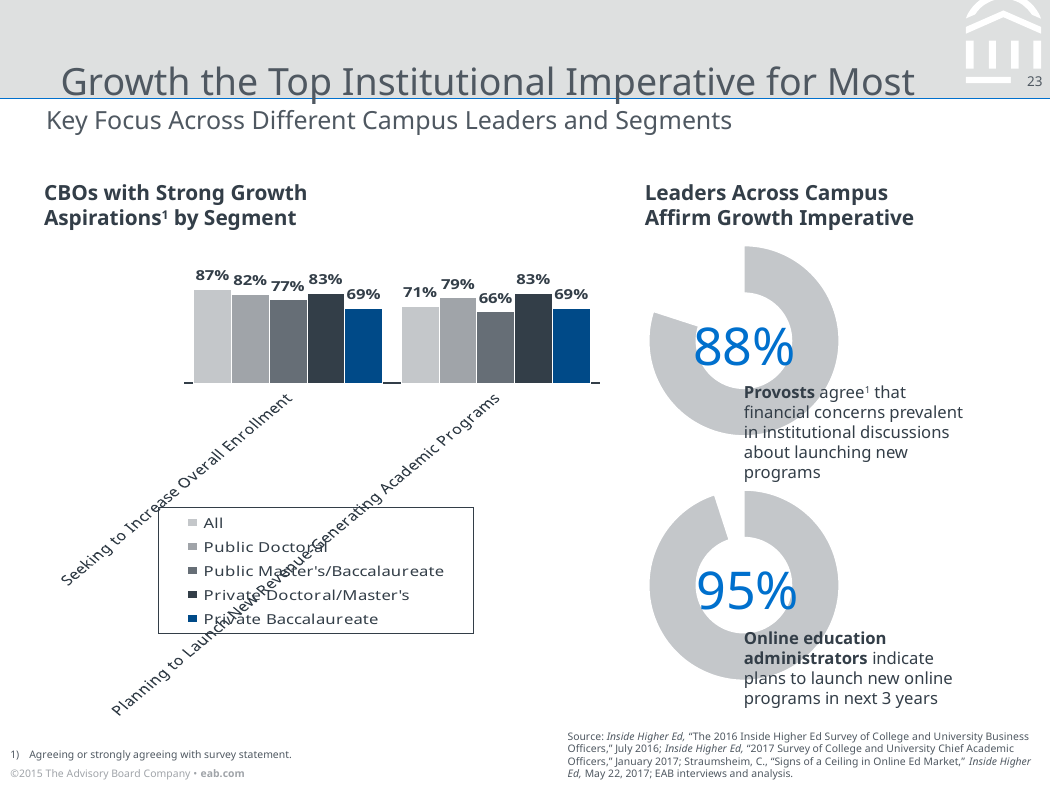
What kind of chart is 'CBOs with Strong Growth Aspirations by Segment'? Bar chart How many series does the legend of the bar chart 'CBOs with Strong Growth Aspirations by Segment' list? 5 In the bar chart 'CBOs with Strong Growth Aspirations by Segment', what is the value for Private Doctoral/Master's under 'Planning to Launch New Revenue-Generating Academic Programs'? 83% In the bar chart 'CBOs with Strong Growth Aspirations by Segment', what is the value for Public Master's/Baccalaureate under 'Planning to Launch New Revenue-Generating Academic Programs'? 66% In the bar chart 'CBOs with Strong Growth Aspirations by Segment', which segment has the lowest value under 'Planning to Launch New Revenue-Generating Academic Programs'? Public Master's/Baccalaureate In the top donut chart under 'Leaders Across Campus Affirm Growth Imperative', what percentage of Provosts agree that financial concerns are prevalent in discussions about launching new programs? 88% In the bar chart 'CBOs with Strong Growth Aspirations by Segment', which segment has the highest value under 'Seeking to Increase Overall Enrollment'? All In the bar chart 'CBOs with Strong Growth Aspirations by Segment', which is larger under 'Seeking to Increase Overall Enrollment': Public Doctoral or Public Master's/Baccalaureate? Public Doctoral In the bar chart 'CBOs with Strong Growth Aspirations by Segment', what is the difference between the All value for 'Seeking to Increase Overall Enrollment' and the All value for 'Planning to Launch New Revenue-Generating Academic Programs'? 16 percentage points How many categories are shown on the x axis of the bar chart 'CBOs with Strong Growth Aspirations by Segment'? 2 In the bottom donut chart under 'Leaders Across Campus Affirm Growth Imperative', what percentage of online education administrators indicate plans to launch new online programs in the next 3 years? 95% In the bar chart 'CBOs with Strong Growth Aspirations by Segment', what is the value for All under 'Seeking to Increase Overall Enrollment'? 87%